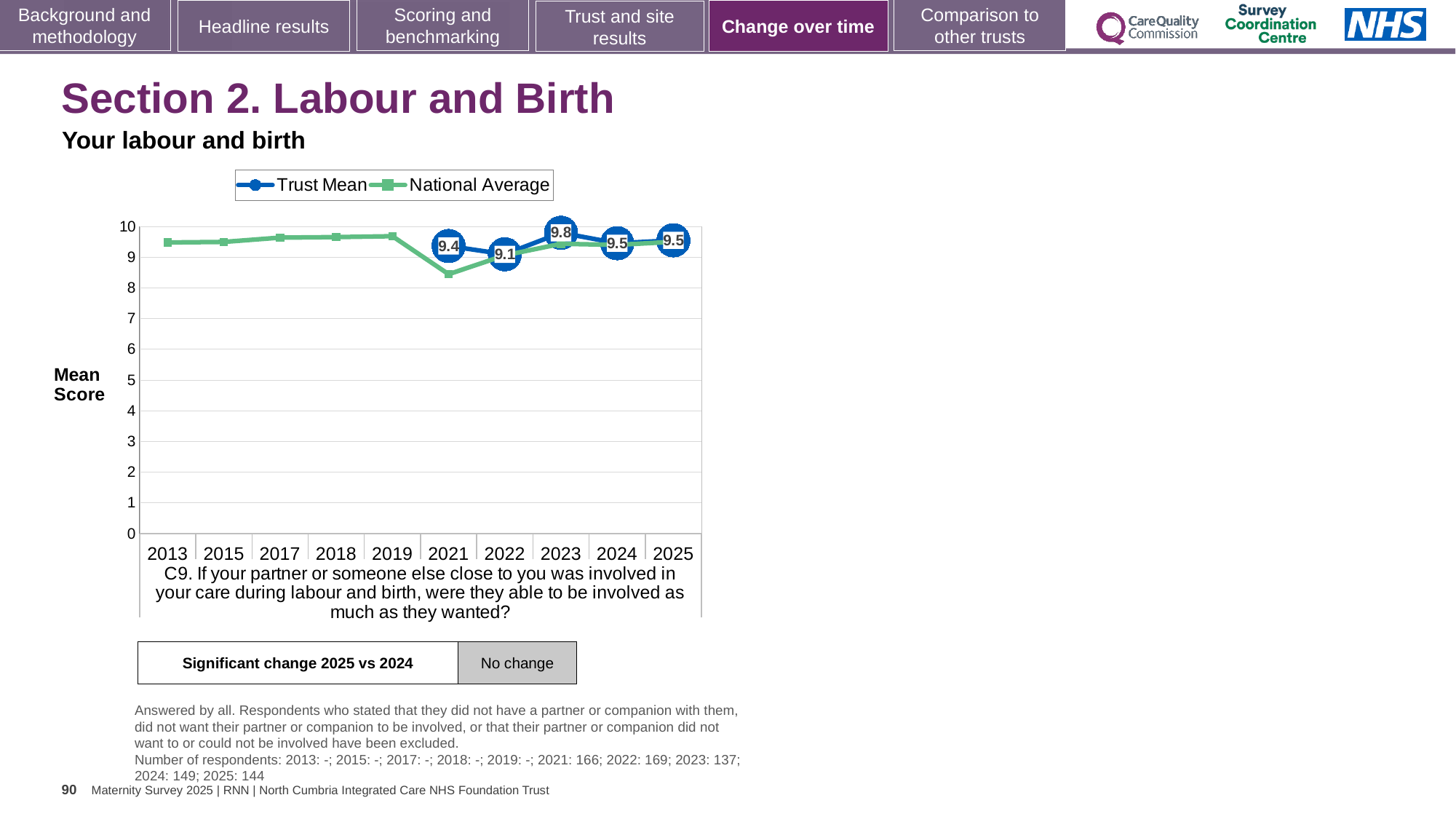
Which year has the larger Trust Mean, 2021 or 2022? 2021 What is the Trust Mean value for 2025? 9.5 Does the Trust Mean rise or fall from 2022 to 2023? rise What is the difference between the Trust Mean in 2023 and in 2022? 0.7 What is the Trust Mean value for 2023? 9.8 In which year is the Trust Mean highest? 2023 In which year is the Trust Mean lowest? 2022 Is the National Average value for 2021 greater or less than 9? less What kind of chart is shown on the slide? line chart How many years are shown on the x axis? 10 What is the Trust Mean value for 2022? 9.1 How many series does the legend list? 2